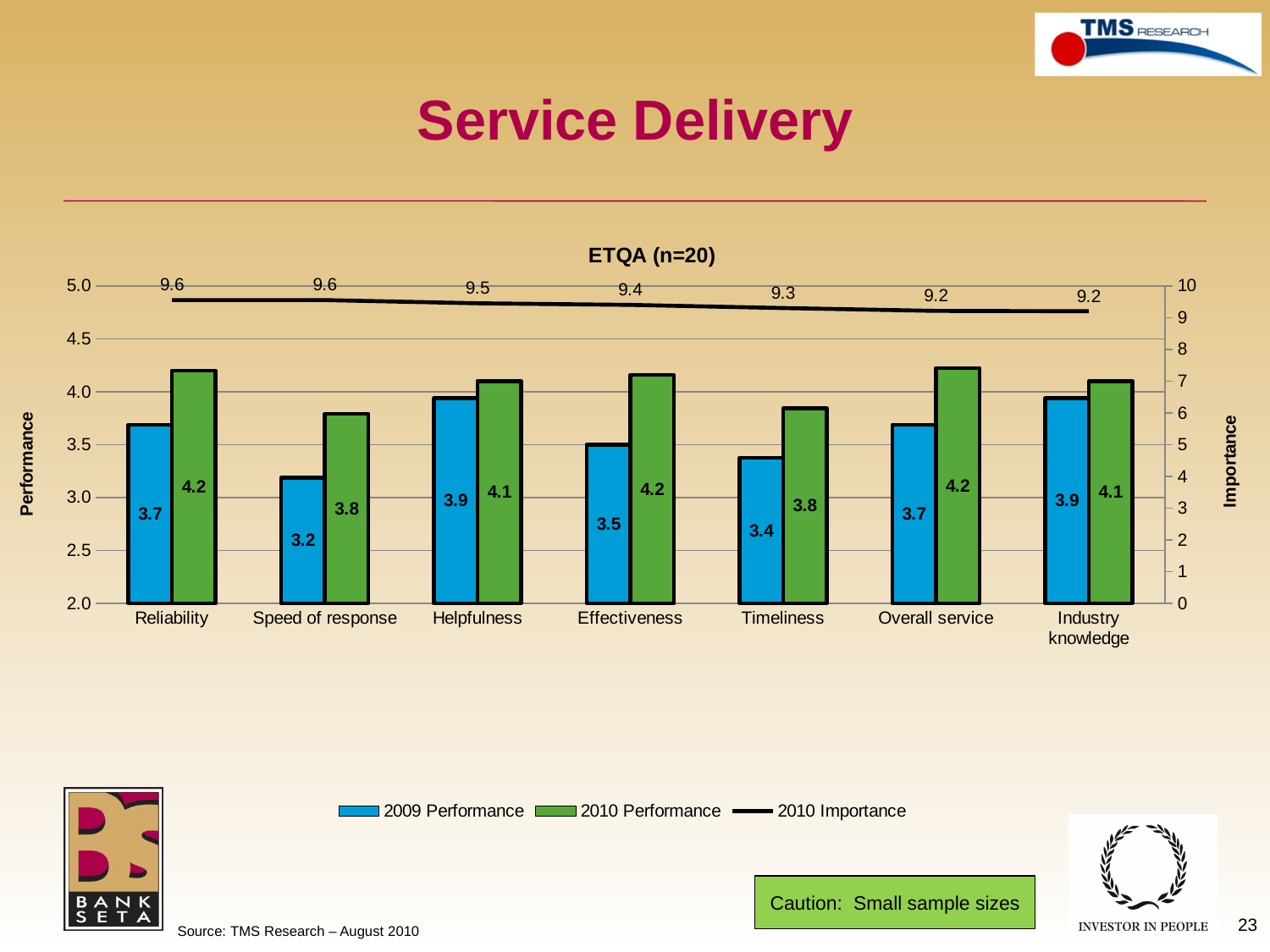
How many series does the legend list? 3 What is the title of the chart? ETQA (n=20) What is the 2009 Performance value for Speed of response? 3.2 What is the difference between the 2010 Performance and 2009 Performance values for Timeliness? 0.4 Which is larger, the 2009 Performance value for Helpfulness or for Effectiveness? Helpfulness Which category has the lowest 2009 Performance value? Speed of response How many categories are shown on the x axis? 7 What is the 2010 Performance value for Effectiveness? 4.2 Does the 2010 Importance line rise or fall from Reliability to Industry knowledge? Fall What is the 2010 Importance value for Timeliness? 9.3 What kind of chart is this? Combined bar and line chart Which category has the highest 2010 Importance value? Reliability and Speed of response (9.6)